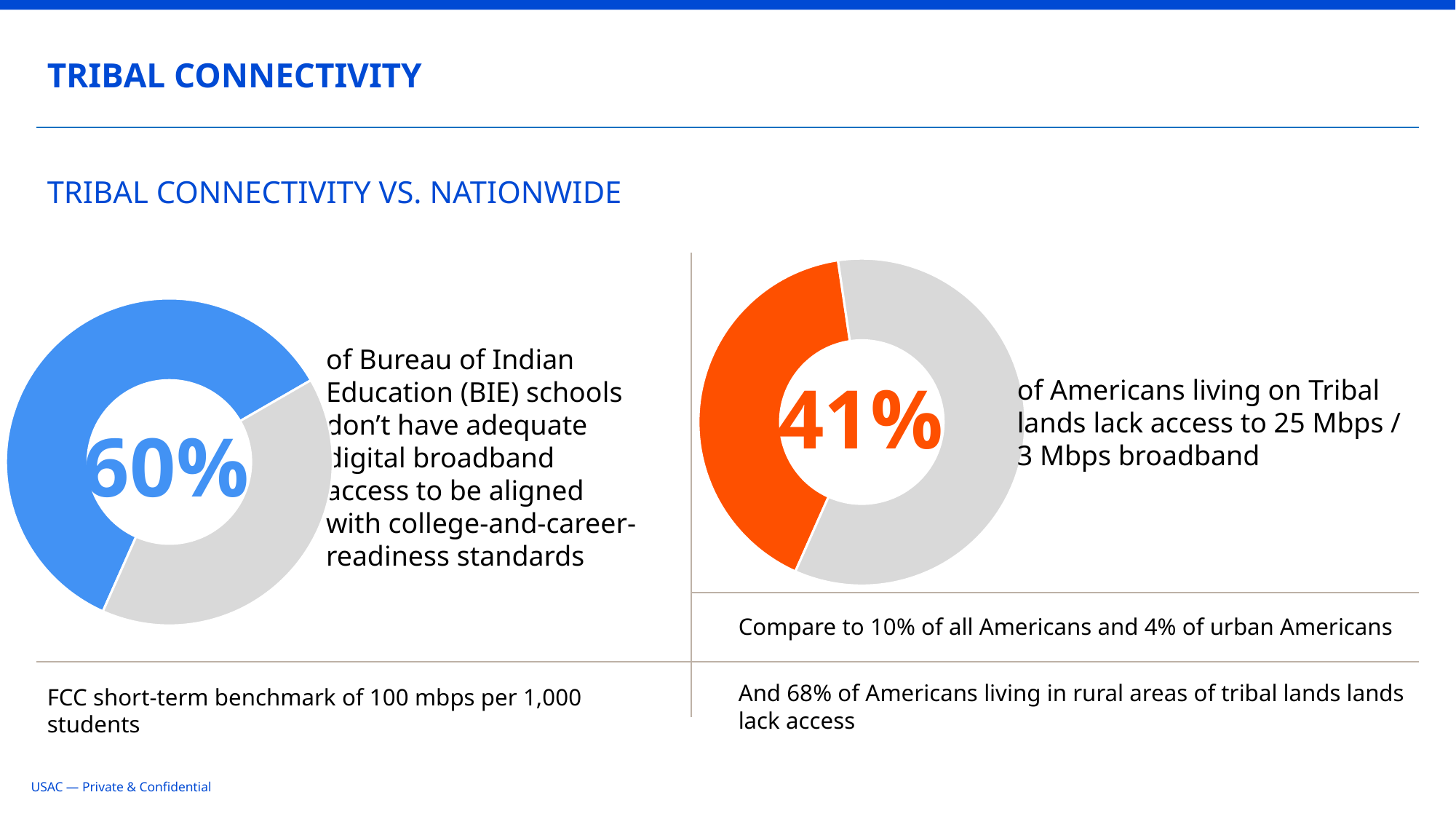
What kind of chart is used on the left side of the slide? donut chart Is the highlighted share in the left donut chart greater or less than 50%? greater What percentage is shown in the centre of the right donut chart? 41% What is the difference in percentage points between the left chart's 60% and the right chart's 41%? 19 percentage points In the right donut chart, what share of the whole does the grey (non-highlighted) segment represent? 59% How many donut charts are on the slide? 2 Which chart shows the larger highlighted percentage, the left chart (BIE schools) or the right chart (Americans on Tribal lands)? the left chart (60%) Is the highlighted share in the right donut chart greater or less than 50%? less What percentage is shown in the centre of the left donut chart? 60% What colour is the highlighted segment in the right donut chart? orange In the left donut chart, what share of the whole does the grey (non-highlighted) segment represent? 40% What colour is the highlighted segment in the left donut chart? blue